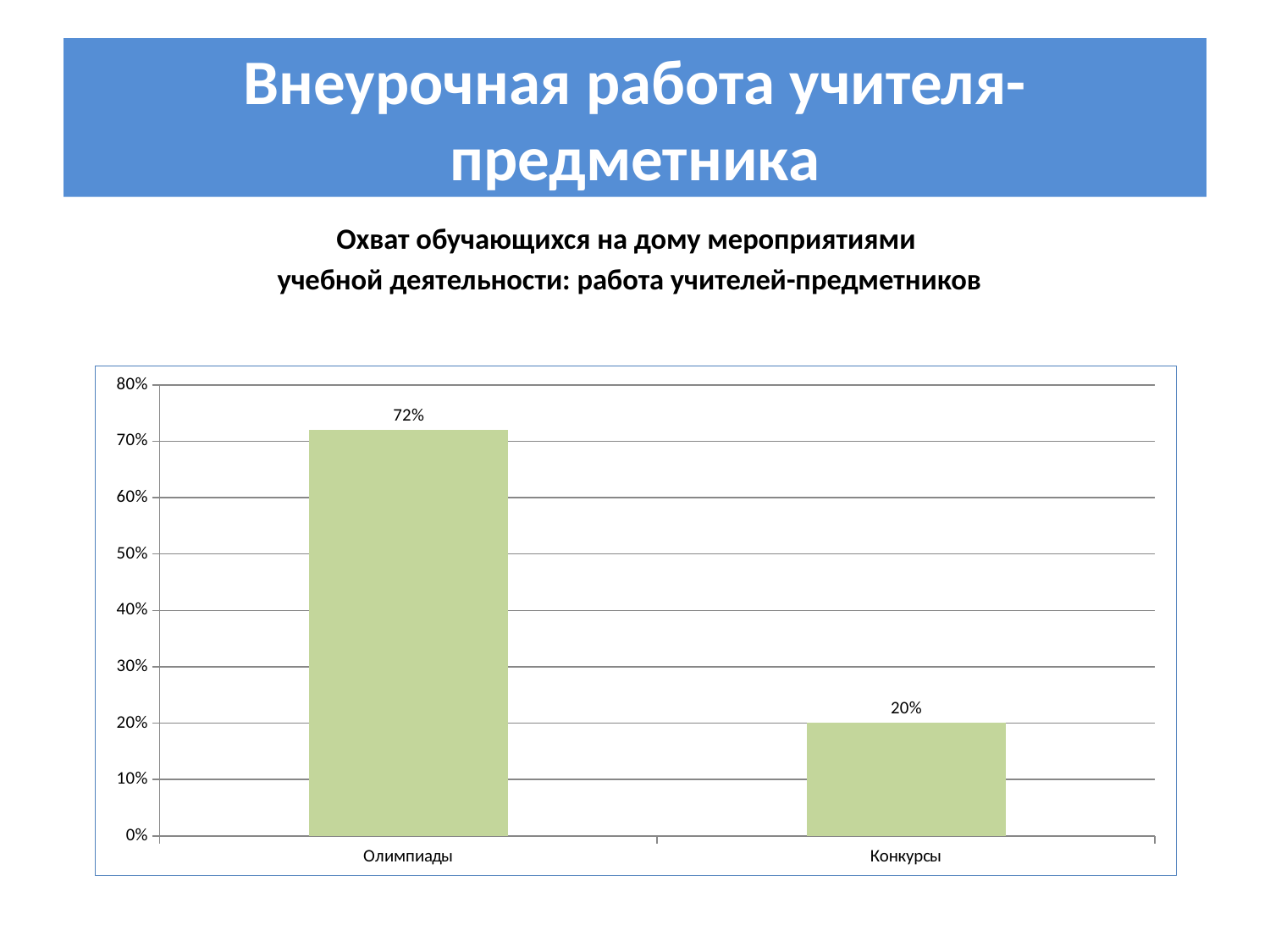
What is the value for Конкурсы? 20% Is the value for Олимпиады greater or less than 50%? greater Which is larger, the value for Олимпиады or the value for Конкурсы? Олимпиады How many categories are shown on the x axis? 2 What colour are the bars in the chart? light green What kind of chart is shown on the slide? bar chart Which category has the highest value? Олимпиады What is the difference between the values for Олимпиады and Конкурсы? 52% What is the value for Олимпиады? 72% Which category has the lowest value? Конкурсы What is the highest value shown on the y axis? 80% Is the value for Конкурсы greater or less than 30%? less